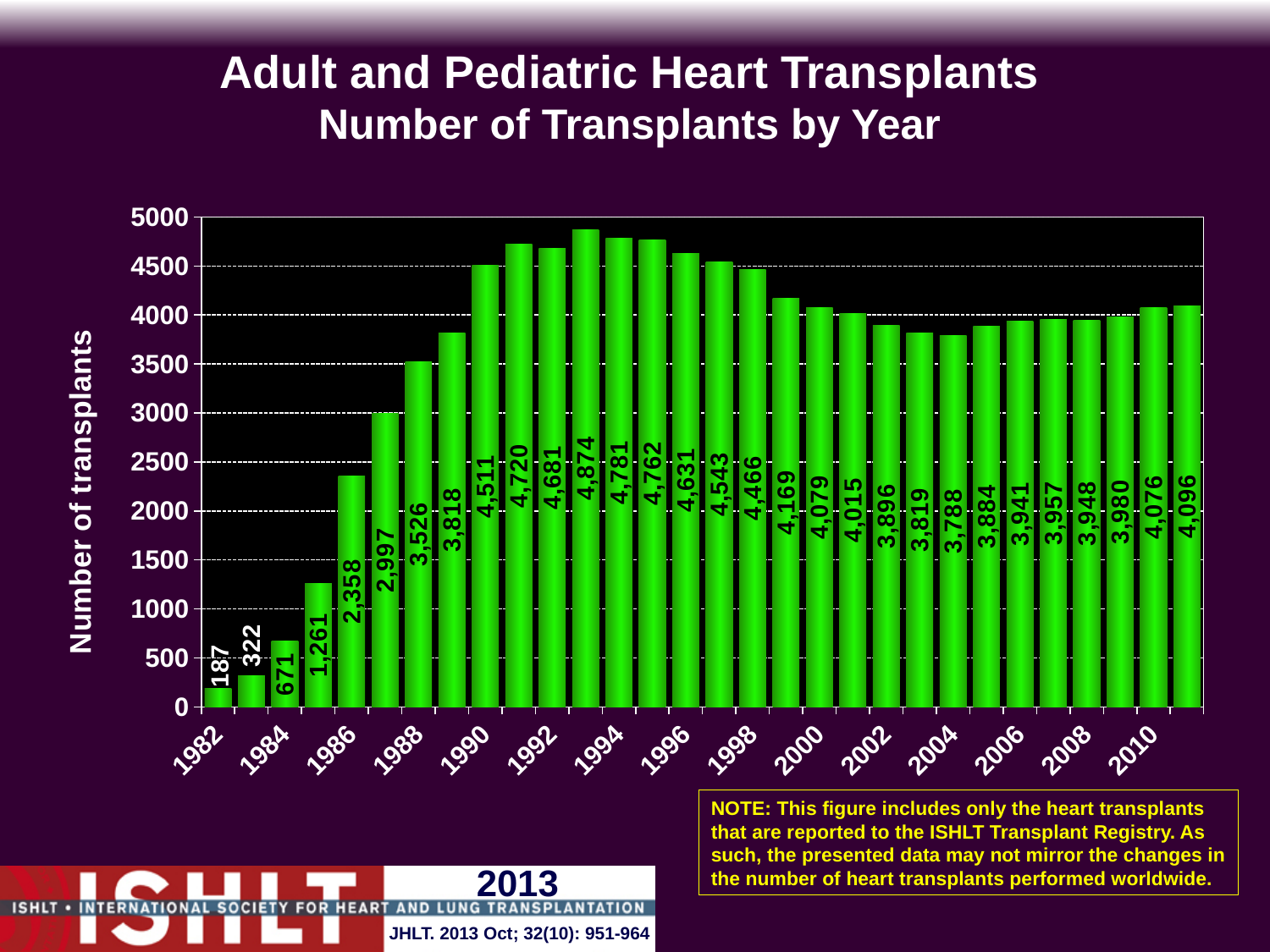
Which year has the highest number of transplants? 1993 What is the number of transplants in 1982? 187 What kind of chart is shown on the slide? Bar chart What is the number of transplants in 2004? 3,788 Is the value for 1998 greater or less than 4000? greater Which year has the lowest number of transplants? 1982 How many bars (years) are shown in the chart? 30 Which year had more transplants, 1996 or 2000? 1996 What is the difference in the number of transplants between 1988 and 1986? 1,168 What is the label of the y axis? Number of transplants What is the number of transplants in 2010? 4,076 What is the number of transplants in 1990? 4,511